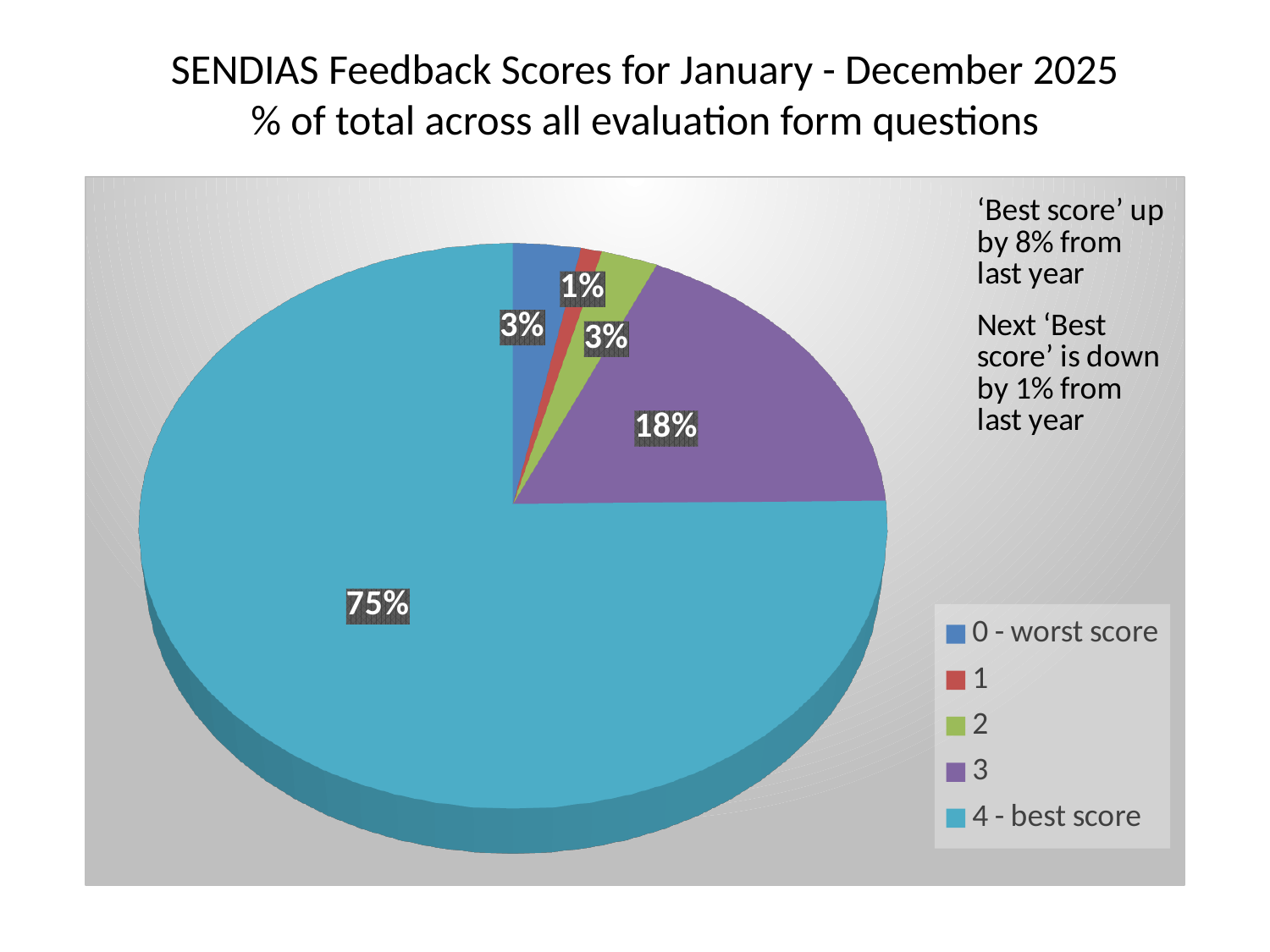
What is the value for score '1'? 1% Which is larger, the share for score '3' or the share for score '2'? 3 What kind of chart is shown on the slide? Pie chart What is the value for score '2'? 3% What is the difference between the share for '4 - best score' and the share for score '3'? 57% Which category has the smallest slice of the pie? 1 How many categories does the legend list? 5 Which category has the largest slice of the pie? 4 - best score What share of the pie does score '3' take? 18% What is the value for '0 - worst score'? 3% What share of the pie does '4 - best score' take? 75% What colour is the slice for '4 - best score'? Light blue